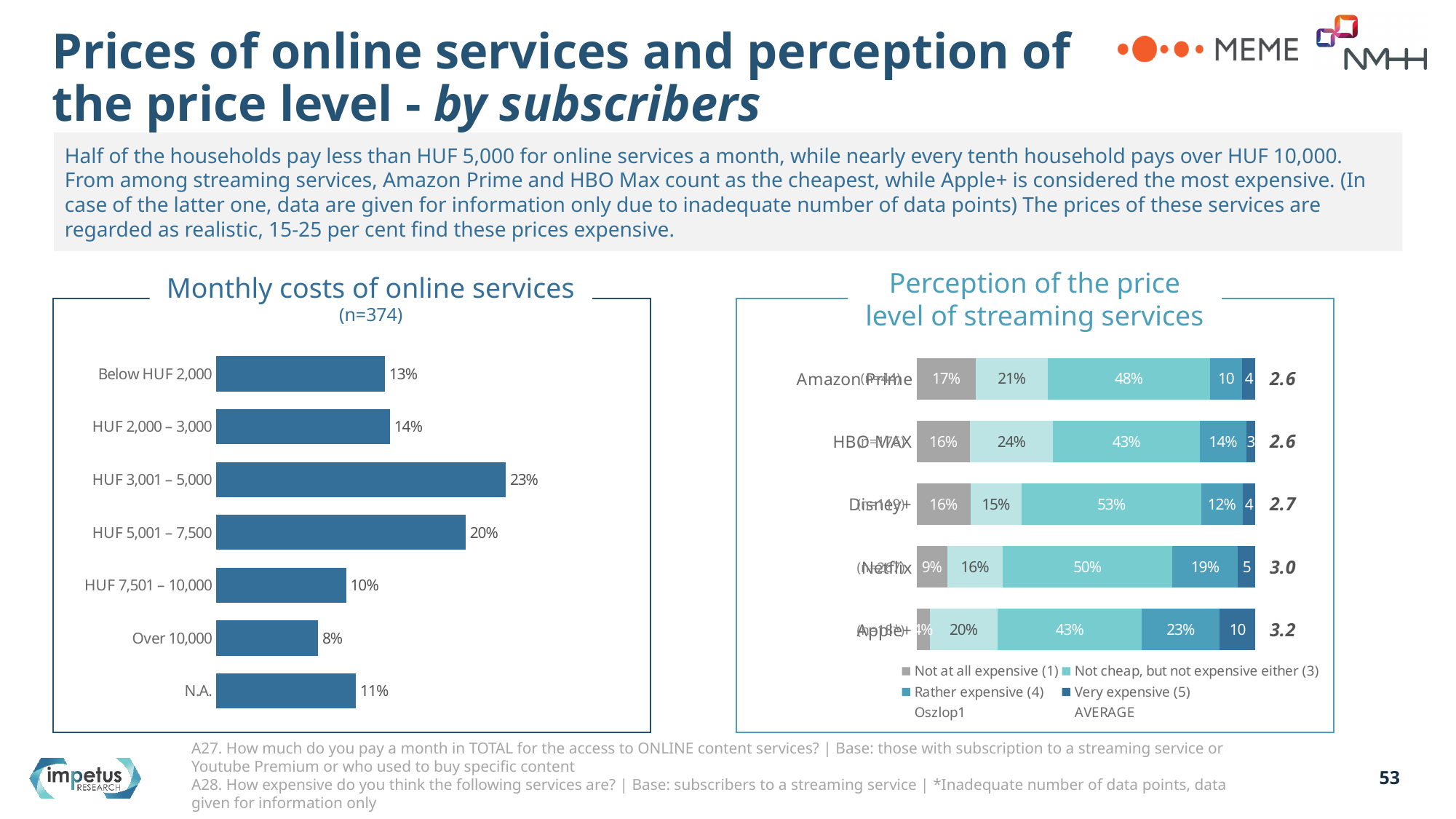
What type of chart is the 'Monthly costs of online services' chart? Bar chart In the 'Monthly costs of online services' chart, which is larger: the share for Below HUF 2,000 or for N.A.? Below HUF 2,000 How many cost categories are shown in the 'Monthly costs of online services' chart? 7 In the 'Perception of the price level of streaming services' chart, which service has the highest average score? Apple+ In the 'Perception of the price level of streaming services' chart, what is the average score shown for Apple+? 3.2 How many streaming services are shown in the 'Perception of the price level of streaming services' chart? 5 In the 'Monthly costs of online services' chart, what is the difference between the shares for HUF 5,001 – 7,500 and HUF 7,501 – 10,000? 10 percentage points In the 'Perception of the price level of streaming services' chart, what percentage of Netflix subscribers rated it 'Not cheap, but not expensive either (3)'? 50% In the 'Monthly costs of online services' chart, which cost category has the lowest share? Over 10,000 What is the sample size (n) shown under the 'Monthly costs of online services' chart title? n=374 In the 'Monthly costs of online services' chart, which cost category has the highest share? HUF 3,001 – 5,000 In the 'Monthly costs of online services' chart, what percentage of households pay HUF 3,001 – 5,000? 23%